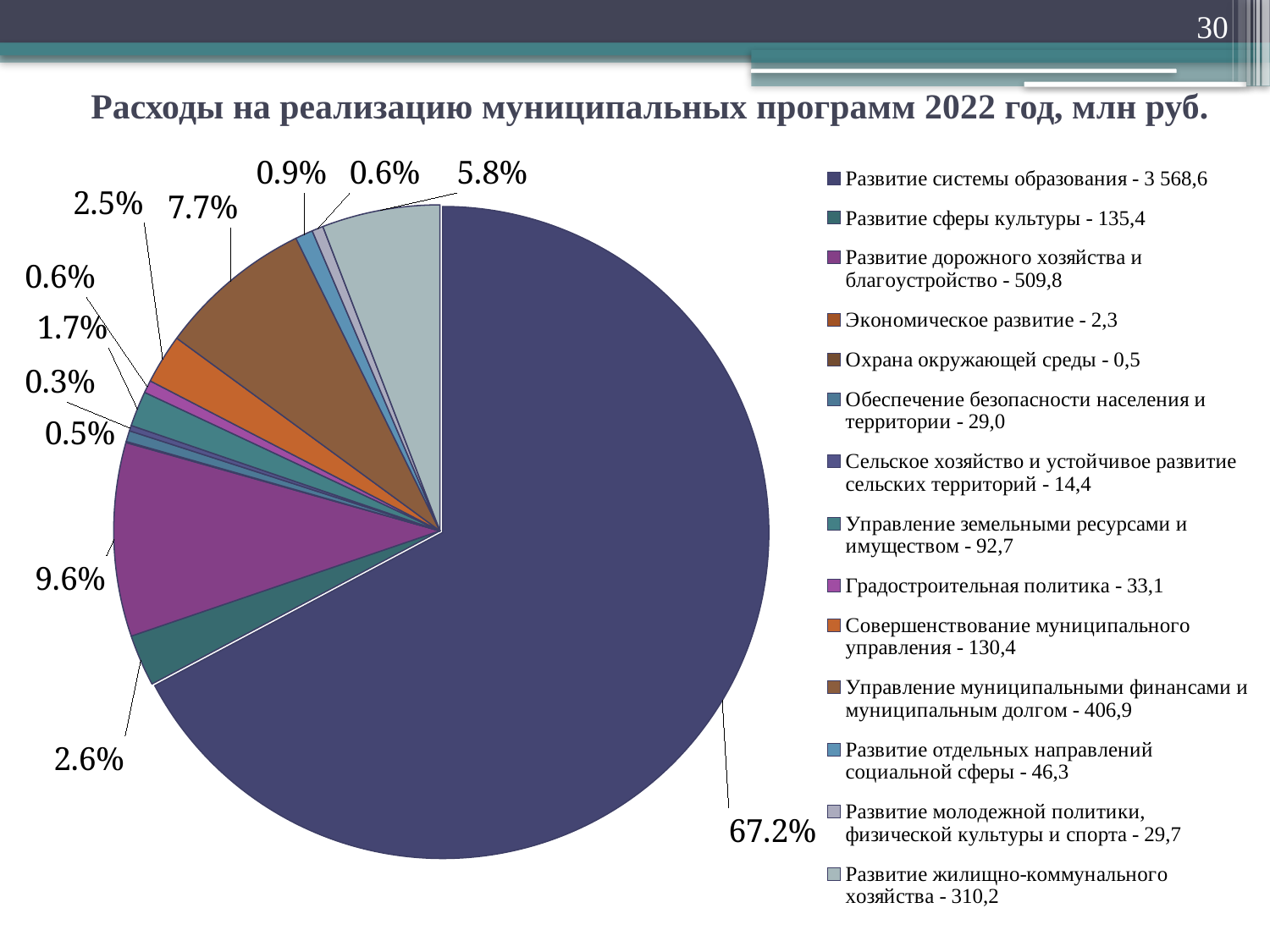
What kind of chart is shown on the slide? pie chart What share of the pie does 'Развитие системы образования' take? 67.2% What is the difference between the legend values for 'Развитие дорожного хозяйства и благоустройство' and 'Управление муниципальными финансами и муниципальным долгом'? 102,9 What share of the pie does 'Развитие дорожного хозяйства и благоустройство' take? 9.6% What is the title of the chart? Расходы на реализацию муниципальных программ 2022 год, млн руб. Which category has the smallest value in the legend? Охрана окружающей среды Which category has the largest share of the pie? Развитие системы образования What value is given in the legend for 'Развитие дорожного хозяйства и благоустройство'? 509,8 Which is larger: 'Развитие сферы культуры' or 'Совершенствование муниципального управления'? Развитие сферы культуры What share of the pie does 'Развитие жилищно-коммунального хозяйства' take? 5.8% What value is given in the legend for 'Управление муниципальными финансами и муниципальным долгом'? 406,9 How many categories does the legend of the pie chart list? 14